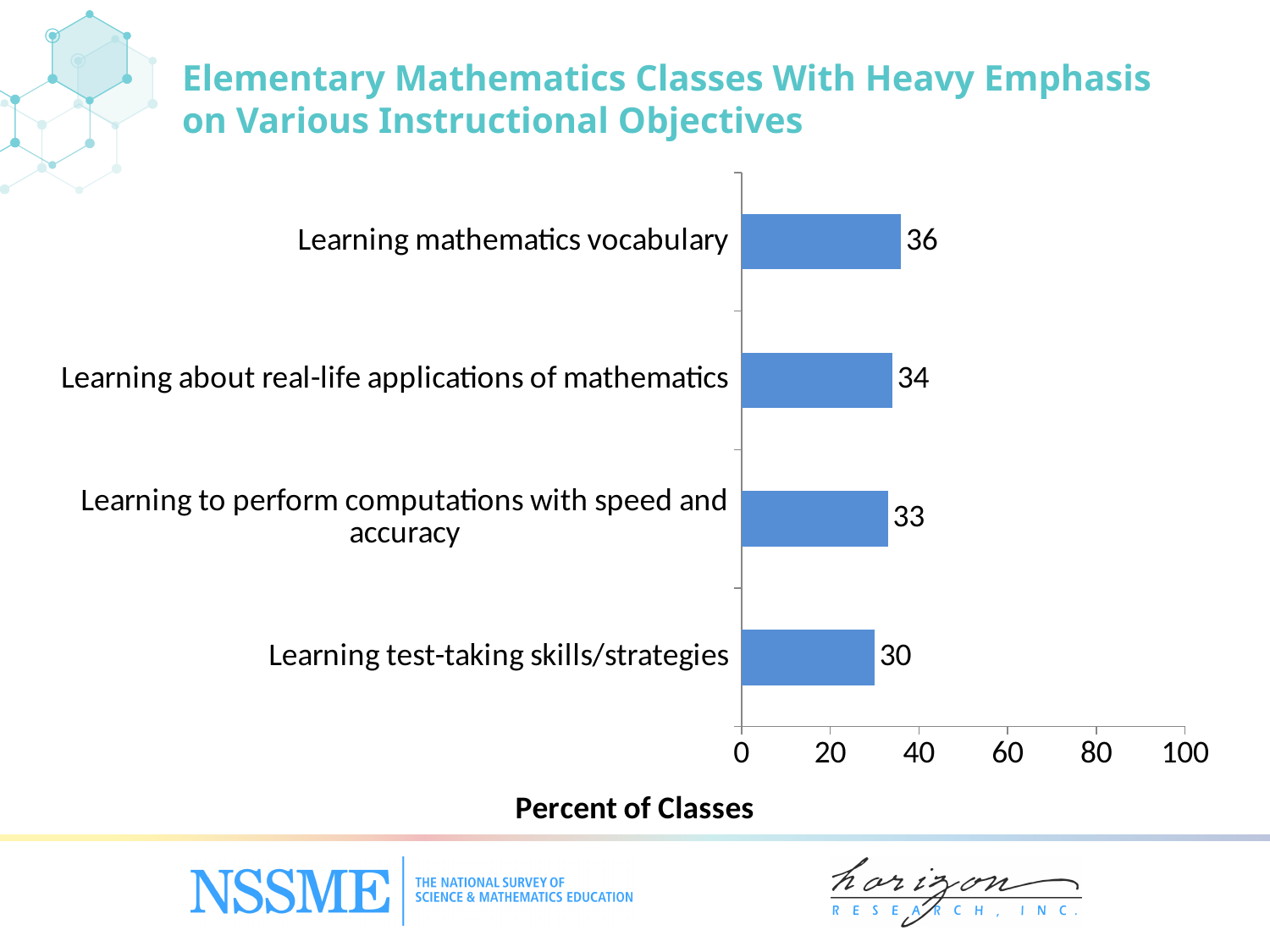
What is the label of the horizontal axis? Percent of Classes Which instructional objective has the highest percent of classes? Learning mathematics vocabulary What is the value for learning to perform computations with speed and accuracy? 33 What percent of classes place heavy emphasis on learning mathematics vocabulary? 36 How many instructional objectives are shown in the chart? 4 Which instructional objective has the lowest percent of classes? Learning test-taking skills/strategies Which is larger: the value for learning about real-life applications of mathematics or the value for learning test-taking skills/strategies? Learning about real-life applications of mathematics Is the value for learning mathematics vocabulary greater or less than 40? less What is the value for learning about real-life applications of mathematics? 34 What is the value for learning test-taking skills/strategies? 30 What kind of chart is shown on the slide? Bar chart What is the difference between the values for learning mathematics vocabulary and learning test-taking skills/strategies? 6